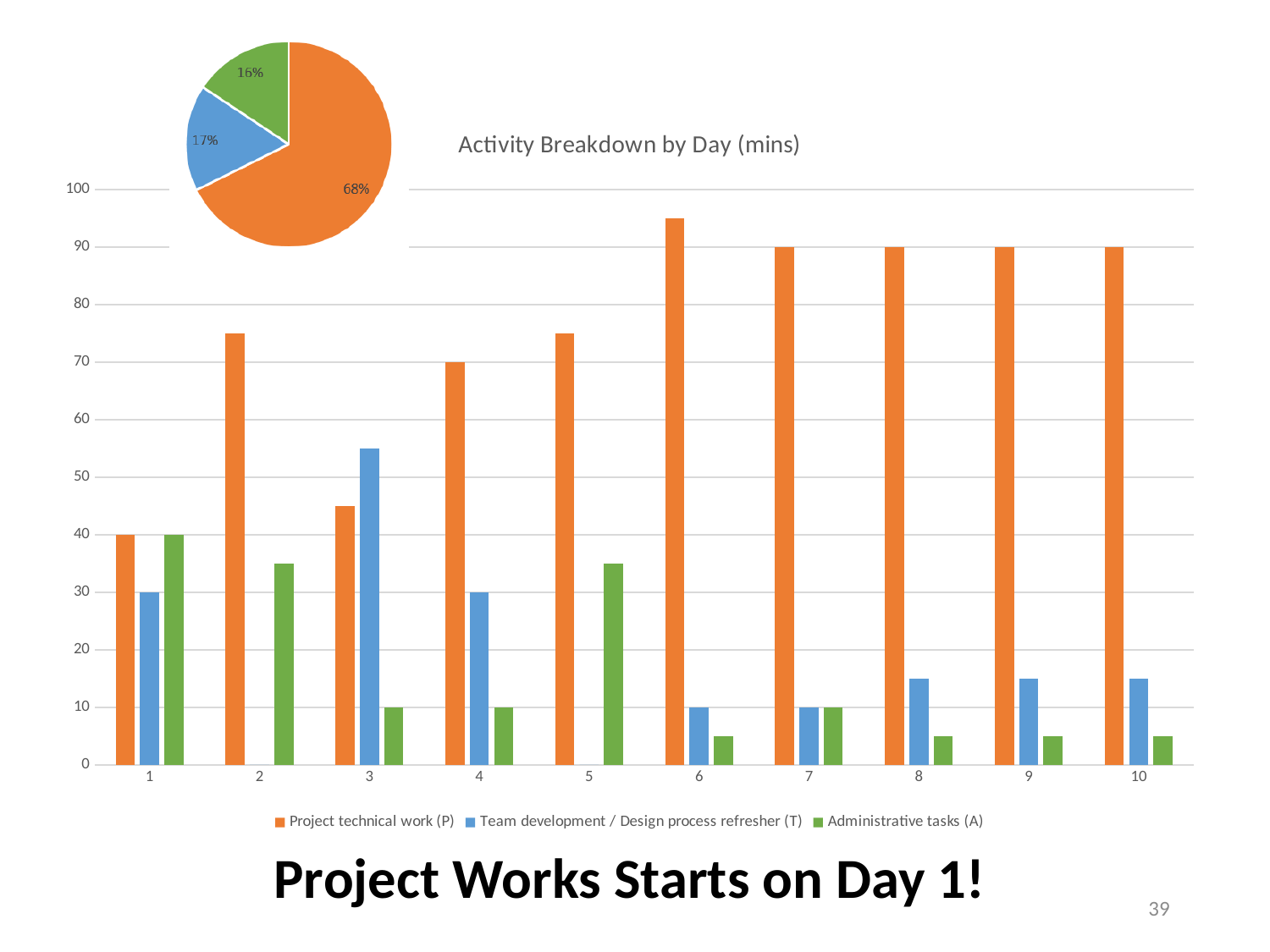
In the pie chart at the top left of the slide, what share does the largest slice have? 68% In the 'Activity Breakdown by Day (mins)' chart, how many days are shown on the x axis? 10 In the 'Activity Breakdown by Day (mins)' chart, what is the value for Project technical work (P) on day 7? 90 In the pie chart at the top left of the slide, what share does the smallest slice have? 16% In the 'Activity Breakdown by Day (mins)' chart, how many series does the legend list? 3 In the 'Activity Breakdown by Day (mins)' chart, what is the difference between Project technical work (P) and Team development / Design process refresher (T) on day 4? 40 How many slices does the pie chart at the top left of the slide have? 3 What kind of chart is the 'Activity Breakdown by Day (mins)' chart? bar chart In the 'Activity Breakdown by Day (mins)' chart, on which day is Project technical work (P) highest? 6 In the 'Activity Breakdown by Day (mins)' chart, what is the value for Team development / Design process refresher (T) on day 1? 30 In the 'Activity Breakdown by Day (mins)' chart, is the value for Project technical work (P) on day 2 greater or less than 70? greater In the 'Activity Breakdown by Day (mins)' chart, on day 3, which is larger: Project technical work (P) or Team development / Design process refresher (T)? Team development / Design process refresher (T)